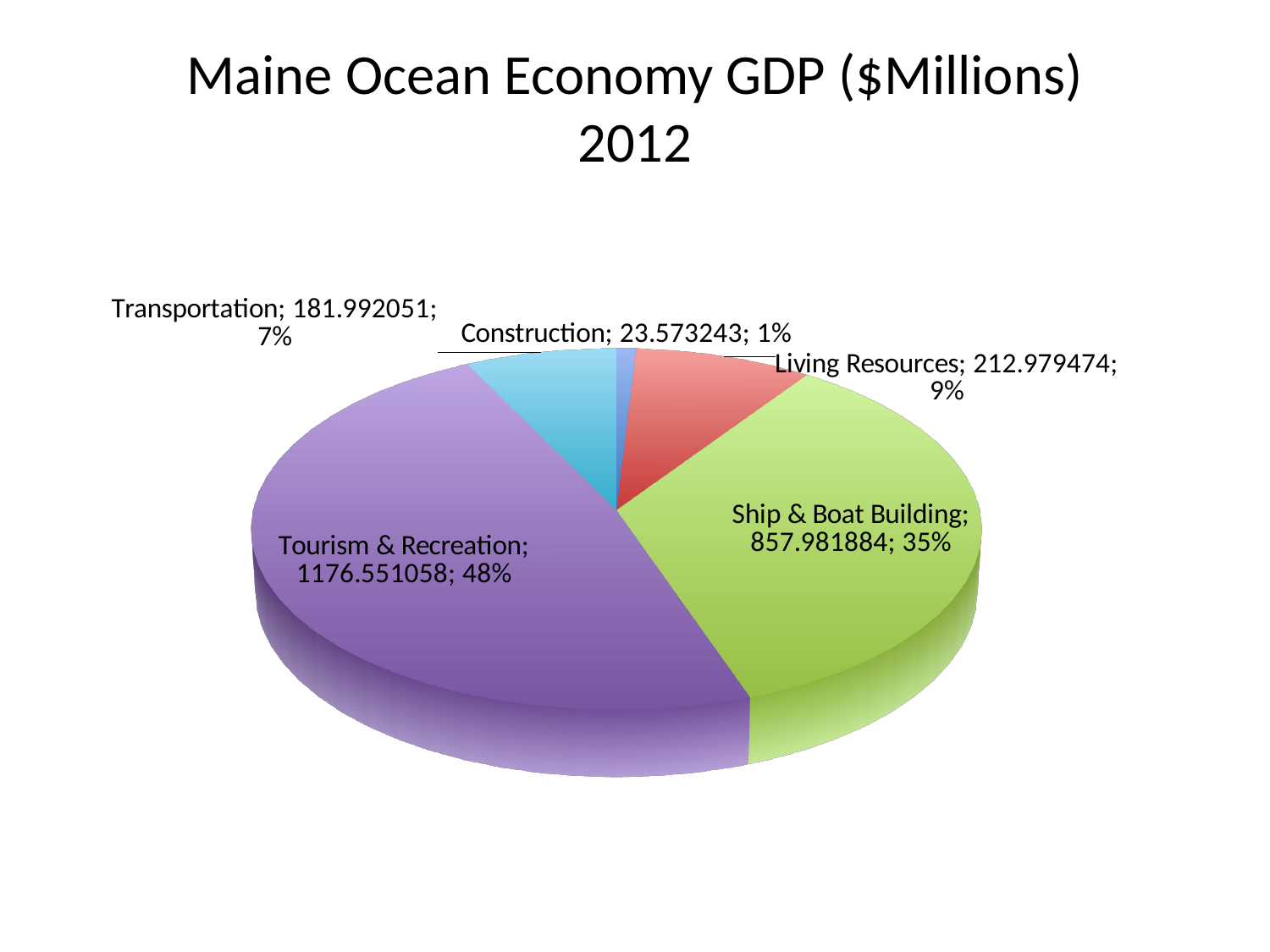
What type of chart is shown on the slide? Pie chart What is the value for Ship & Boat Building? 857.981884 Which category has the largest share of the pie? Tourism & Recreation What share of the pie does Ship & Boat Building represent? 35% What is the difference between the values for Tourism & Recreation and Ship & Boat Building? 318.569174 What is the value for Living Resources? 212.979474 Which category has the smallest share of the pie? Construction What is the value for Construction? 23.573243 What is the title of the chart? Maine Ocean Economy GDP ($Millions) 2012 What share of the pie does Transportation represent? 7% How many categories are shown in the pie chart? 5 What is the value for Tourism & Recreation? 1176.551058